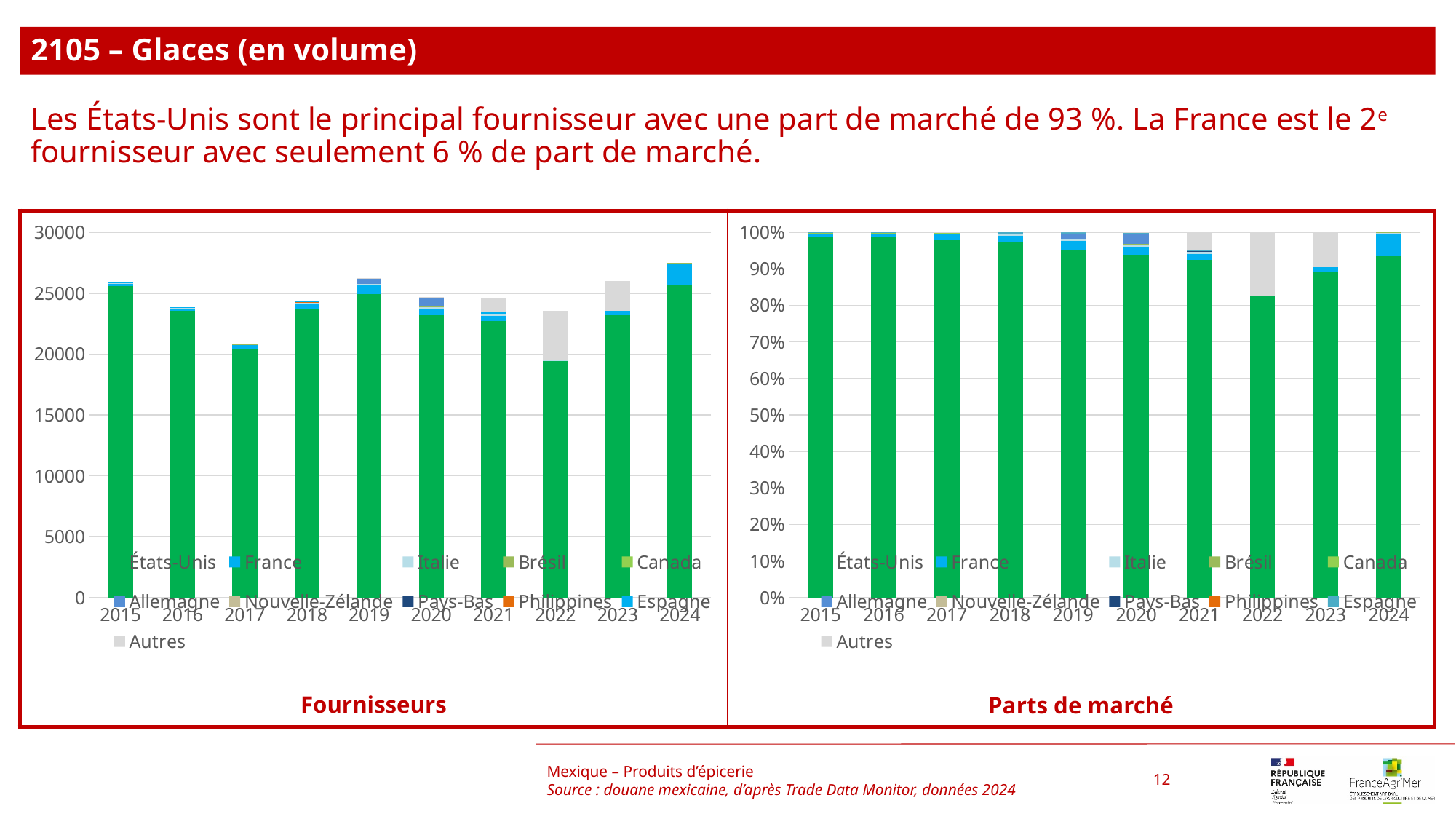
How many years are shown on the x axis of the "Parts de marché" chart? 10 In the "Fournisseurs" chart, which year has the highest total bar? 2024 What kind of chart is the "Fournisseurs" chart on the left? Stacked bar chart In the legend of the "Fournisseurs" chart, which series is shown in grey? Autres In the "Fournisseurs" chart, which year has the larger total bar, 2015 or 2017? 2015 What is the title shown under the right-hand chart? Parts de marché In the "Fournisseurs" chart, which year has the lowest total bar? 2017 How many series does the legend of the "Fournisseurs" chart list? 11 In the "Fournisseurs" chart, is the total for 2024 greater or less than 25000? greater In the "Fournisseurs" chart, is the total for 2017 greater or less than 25000? less In the "Parts de marché" chart, is the share of États-Unis in 2022 greater or less than 90%? less